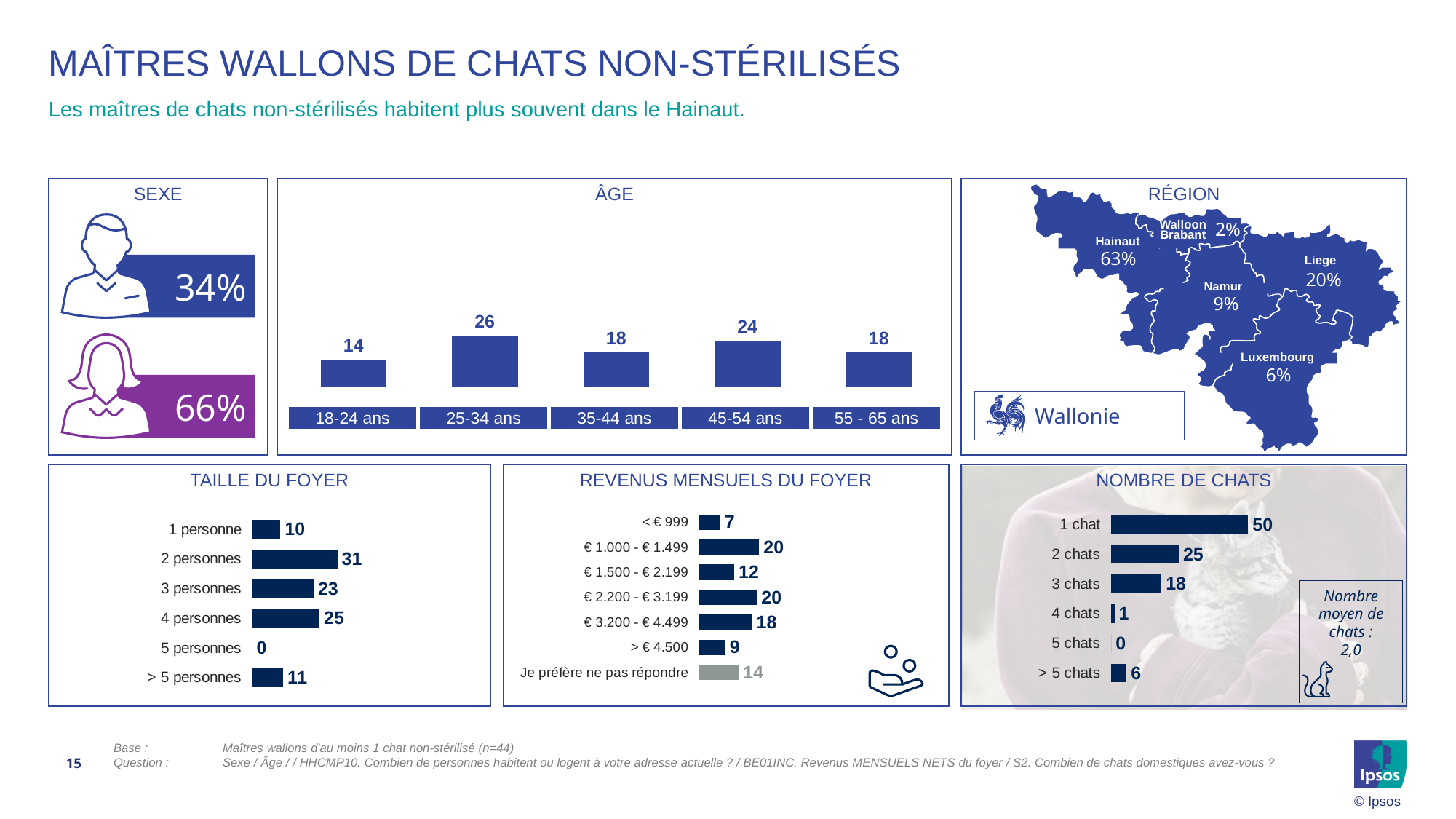
In the TAILLE DU FOYER chart, what is the difference between the values for 2 personnes and 3 personnes? 8 In the TAILLE DU FOYER chart, which category has the highest value? 2 personnes In the NOMBRE DE CHATS chart, what is the difference between the values for 2 chats and 3 chats? 7 What kind of chart is the TAILLE DU FOYER chart? bar chart In the REVENUS MENSUELS DU FOYER chart, what is the value for € 3.200 - € 4.499? 18 In the ÂGE chart, which age group has the lowest value? 18-24 ans In the ÂGE chart, what is the value for 25-34 ans? 26 In the TAILLE DU FOYER chart, what is the value for > 5 personnes? 11 In the NOMBRE DE CHATS chart, what is the value for 1 chat? 50 In the REVENUS MENSUELS DU FOYER chart, which is larger, the value for < € 999 or the value for > € 4.500? > € 4.500 In the REVENUS MENSUELS DU FOYER chart, how many categories are shown? 7 In the ÂGE chart, how many age categories are shown? 5